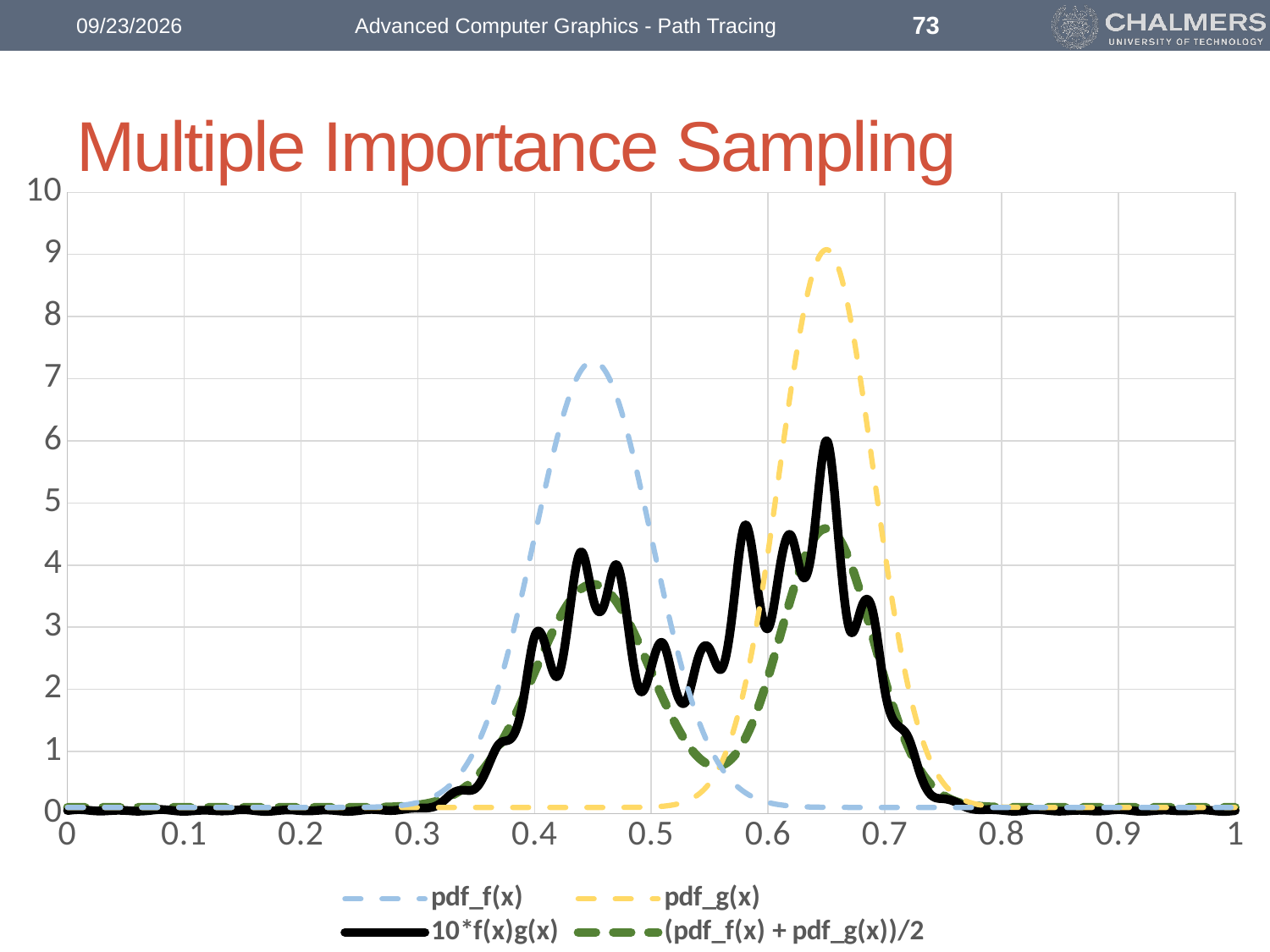
How many series does the legend list? 4 What is the maximum value shown on the y axis? 10 Is the value of pdf_f(x) at x = 0.2 greater or less than 1? less What is the title of the slide containing the chart? Multiple Importance Sampling Is the peak value of (pdf_f(x) + pdf_g(x))/2 greater or less than 5? less What kind of chart is shown on the slide? line chart At x = 0.65, which is larger: pdf_f(x) or pdf_g(x)? pdf_g(x) Is the peak value of pdf_g(x) greater or less than 8? greater Does pdf_f(x) rise or fall as x goes from 0.5 to 0.6? fall Which series is drawn as a solid black line? 10*f(x)g(x) Which series reaches the highest peak value on the chart? pdf_g(x)